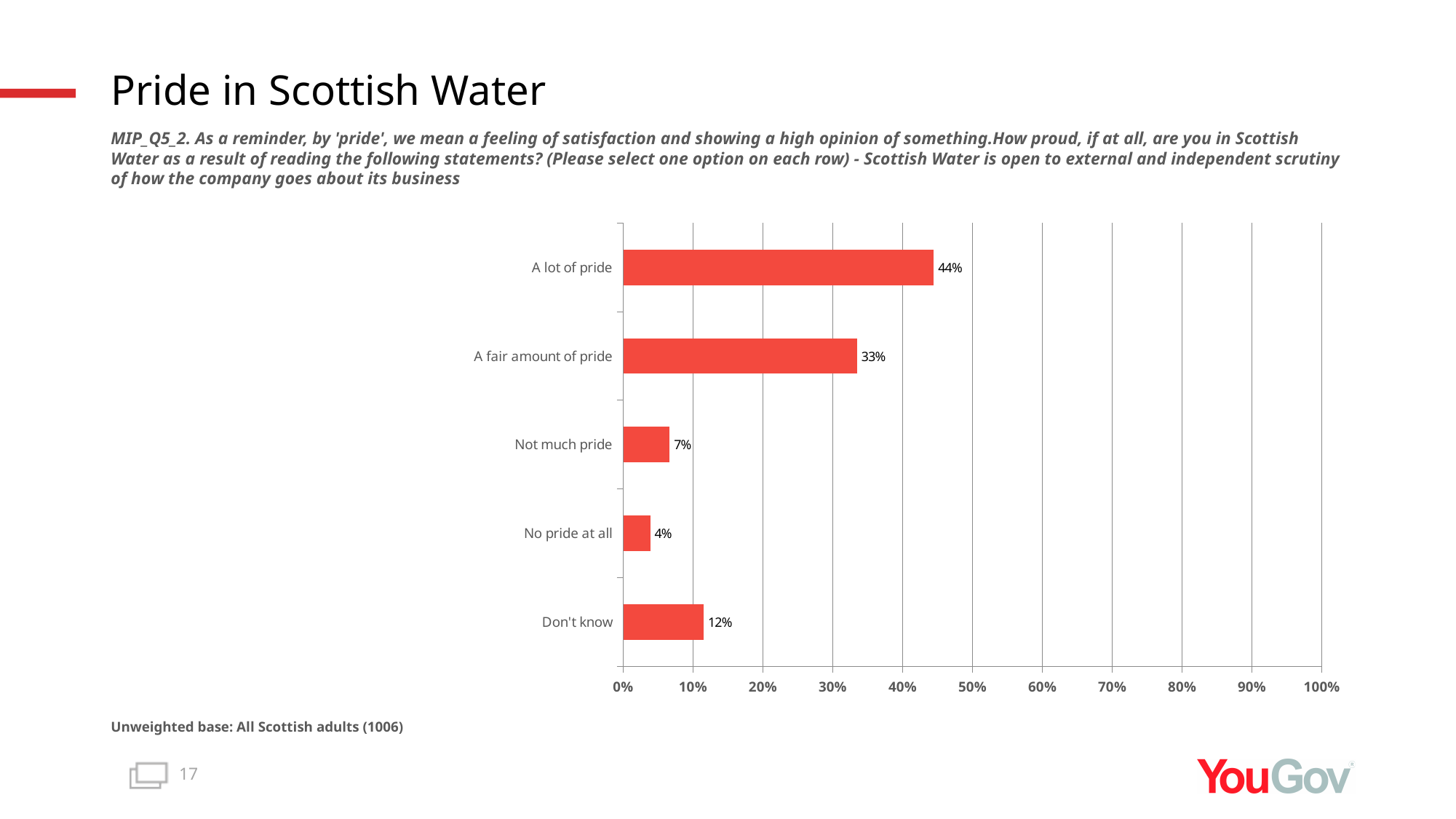
Which category has the highest value? A lot of pride What is the unweighted base stated below the chart? All Scottish adults (1006) What is the value for 'No pride at all'? 4% Is the value for 'A lot of pride' greater or less than 40%? greater Which category has the lowest value? No pride at all What percentage of respondents said they feel 'A lot of pride'? 44% What percentage answered 'Don't know'? 12% Which is larger: 'Not much pride' or 'Don't know'? Don't know What is the difference between 'A lot of pride' and 'A fair amount of pride'? 11% How many categories are shown in the chart? 5 What is the value for 'A fair amount of pride'? 33% What kind of chart is shown on the slide? Bar chart